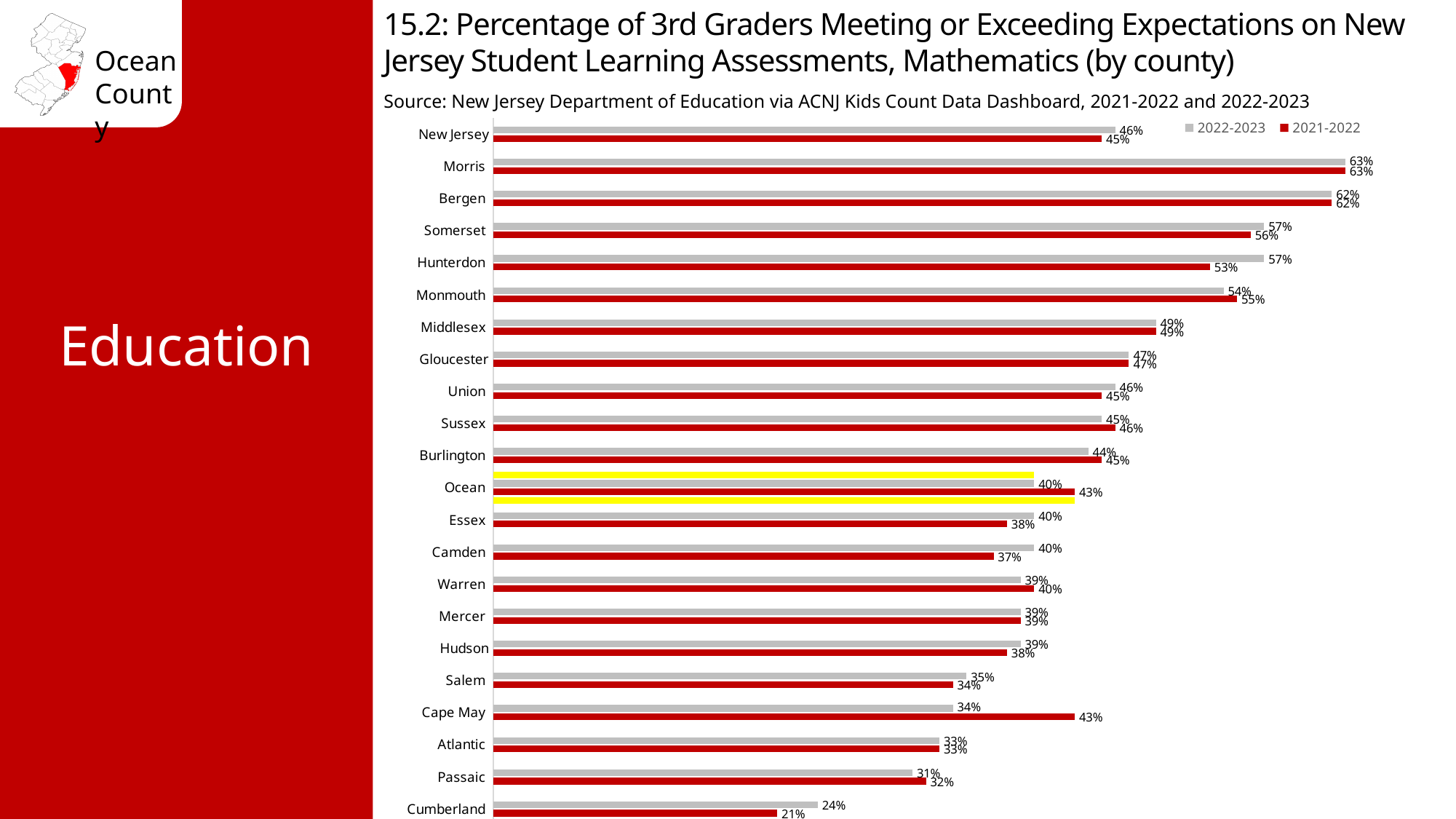
For Ocean, which is larger: the 2022-2023 value or the 2021-2022 value? 2021-2022 What is the 2021-2022 value for Cape May? 43% How many counties or regions are listed on the chart? 22 What is the difference between the 2022-2023 and 2021-2022 values for Hunterdon? 4% Which county has the highest 2022-2023 value? Morris What type of chart is shown on the slide? Bar chart How many series does the legend list? 2 Which county has the lowest 2021-2022 value? Cumberland Which is larger: the 2022-2023 value for Camden or the 2022-2023 value for Salem? Camden What is the 2022-2023 value for Hunterdon? 57% What is the 2022-2023 value for Ocean? 40% What is the difference between the 2021-2022 and 2022-2023 values for Cape May? 9%